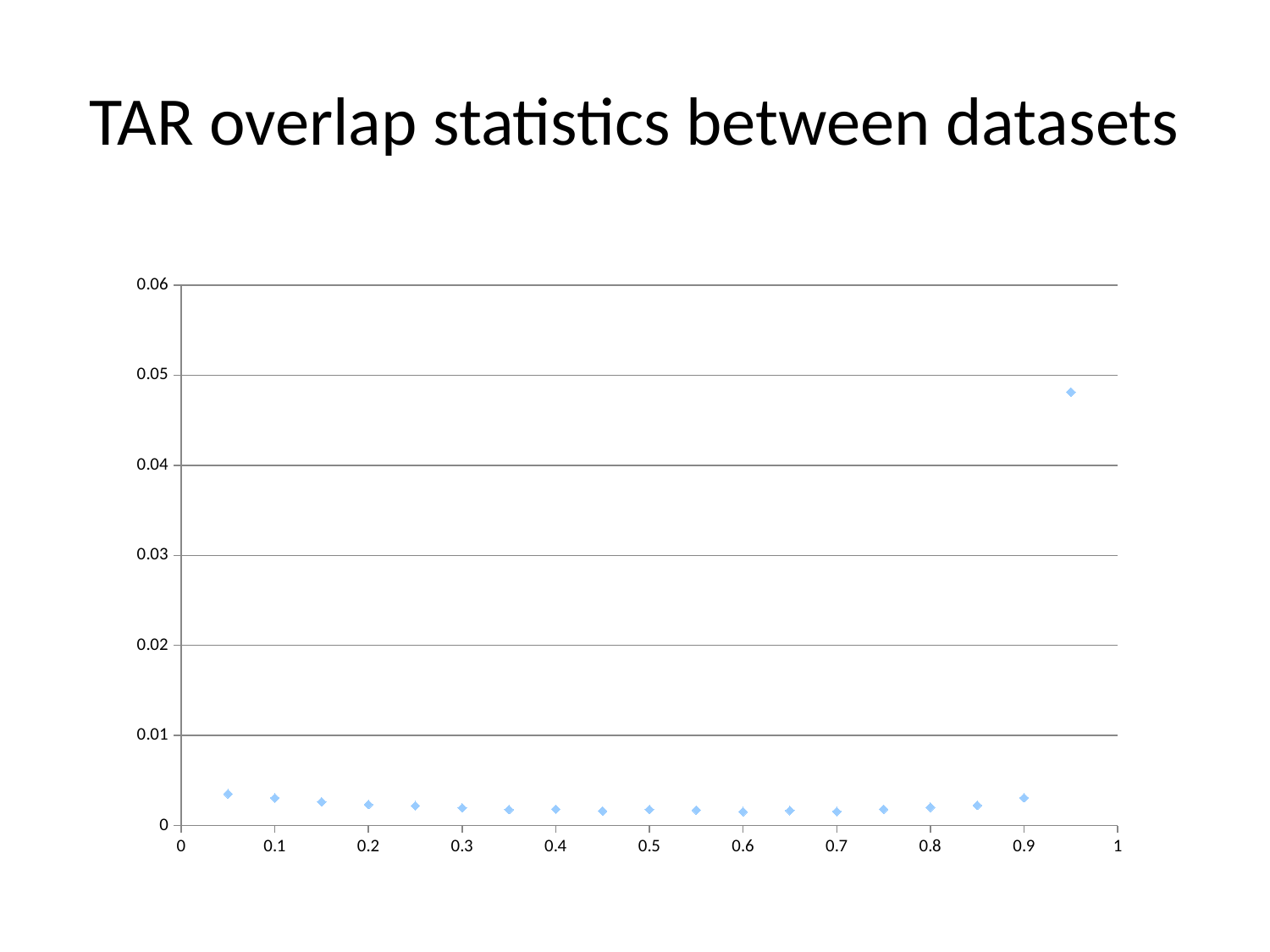
How many data points are plotted on the chart? 19 Is the value at x = 0.95 greater or less than 0.05? less What is the title of the chart? TAR overlap statistics between datasets Is the value at x = 0.05 greater or less than 0.01? less Between x = 0.05 and x = 0.4, do the plotted values rise or fall as x increases? fall At which x value is the plotted value highest? 0.95 Which has the larger value, the point at x = 0.95 or the point at x = 0.05? x = 0.95 What kind of chart is shown on the slide? scatter chart What is the highest value shown on the y axis? 0.06 Is the value at x = 0.5 greater or less than 0.01? less Which has the larger value, the point at x = 0.05 or the point at x = 0.7? x = 0.05